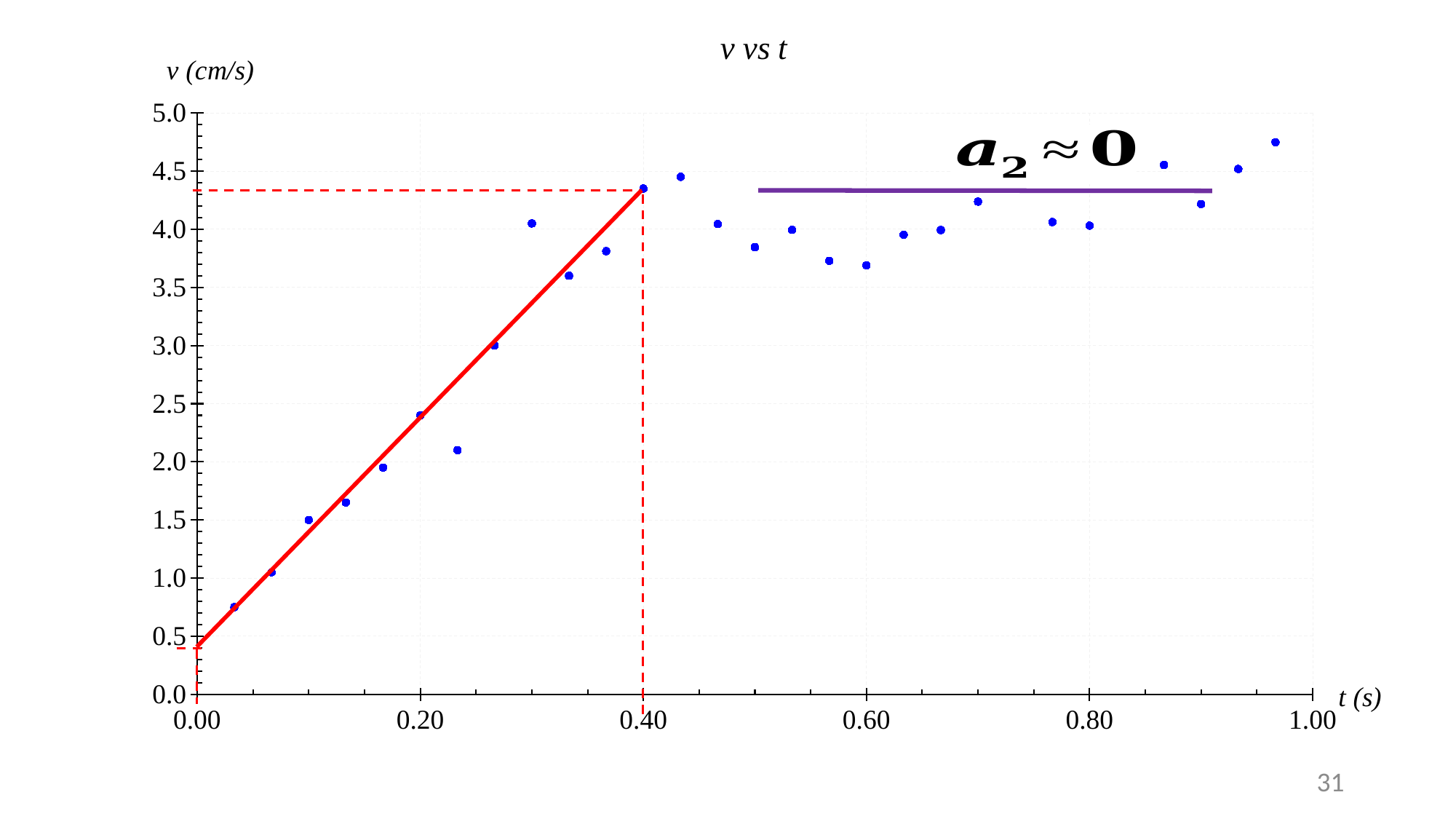
What annotation is written above the purple horizontal line on the chart? a₂ ≈ 0 Which has the larger value of v: the point at t = 0.40 s or the point at t = 0.60 s? t = 0.40 s Is the value of v at t = 0.40 s greater or less than 4.5? less Is the value of v at t = 0.40 s greater or less than 4.0? greater What kind of chart is shown on the slide? scatter plot Is the value of v at t = 0.20 s greater or less than 2.0? greater What is the title of the chart? v vs t Between t = 0.00 s and t = 0.40 s, do the plotted values of v rise or fall? rise Which has the larger value of v: the point at t = 0.20 s or the point at t = 0.80 s? t = 0.80 s